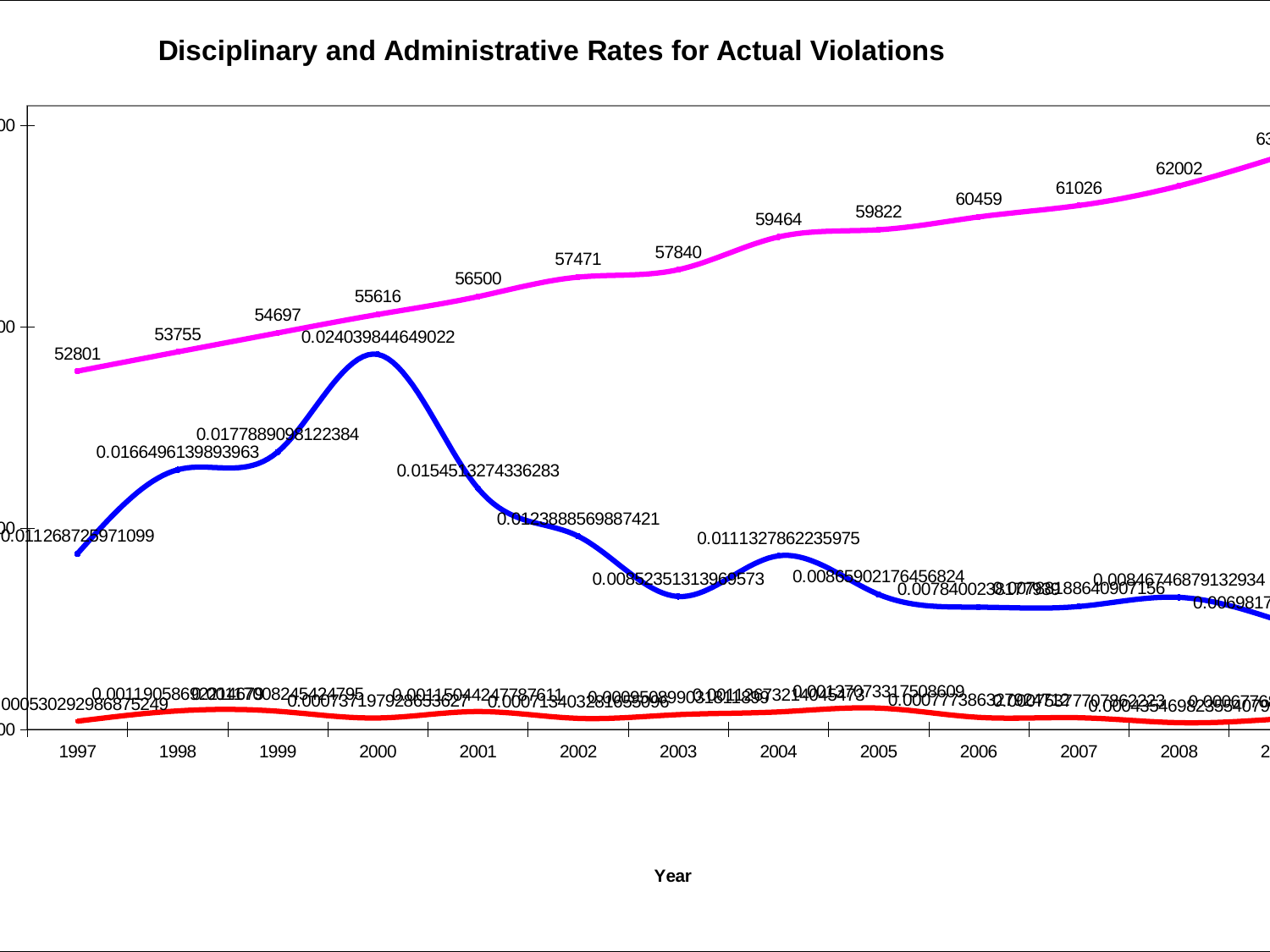
How many lines are plotted on the chart? 3 What is the difference between the magenta (top) line's values for 2005 and 2004? 358 What is the value labelled on the magenta (top) line for 1997? 52801 In which year does the blue (middle) line reach its highest value? 2000 What is the difference between the magenta (top) line's values for 2008 and 1997? 9201 What kind of chart is shown on the slide? line chart What is the value labelled on the magenta (top) line for 2004? 59464 What is the value labelled on the blue (middle) line for 2000? 0.024039844649022 What is the value labelled on the magenta (top) line for 2008? 62002 What is the title of the chart? Disciplinary and Administrative Rates for Actual Violations What is the x-axis title of the chart? Year Does the magenta (top) line rise or fall from 1997 to 2008? rises